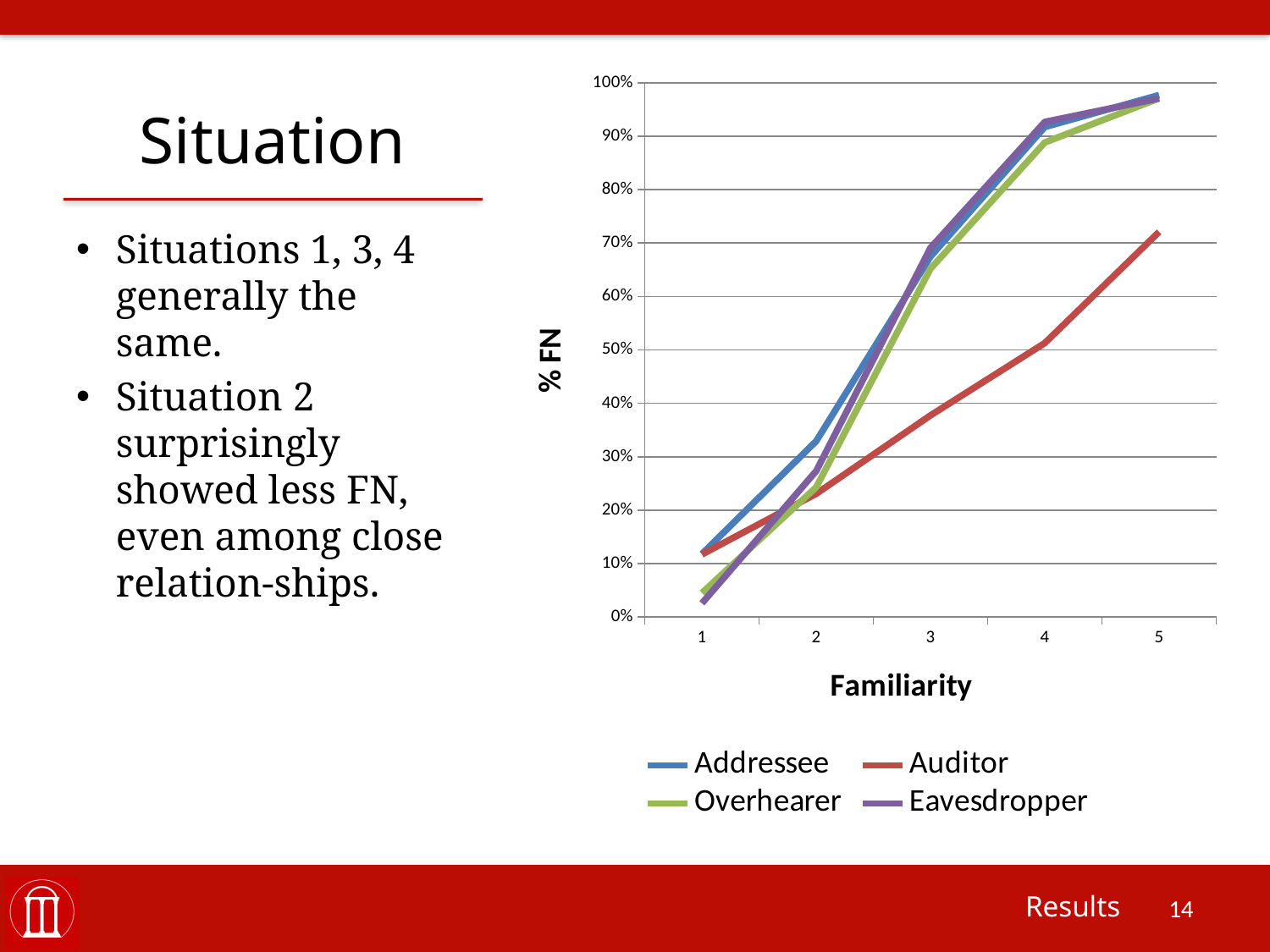
How many familiarity levels are plotted along the x axis? 5 Is the value for Overhearer at familiarity 1 greater or less than 10%? less What is the title of the x axis? Familiarity Is the value for Auditor at familiarity 5 greater or less than 80%? less What is the title of the y axis? % FN What kind of chart is shown on the slide? line chart Which series has the lowest value at familiarity 5? Auditor Does the Auditor series rise or fall as familiarity increases from 1 to 5? rises Is the value for Auditor at familiarity 3 greater or less than 50%? less How many series does the chart's legend list? 4 At familiarity 4, which is larger: the value for Addressee or the value for Auditor? Addressee